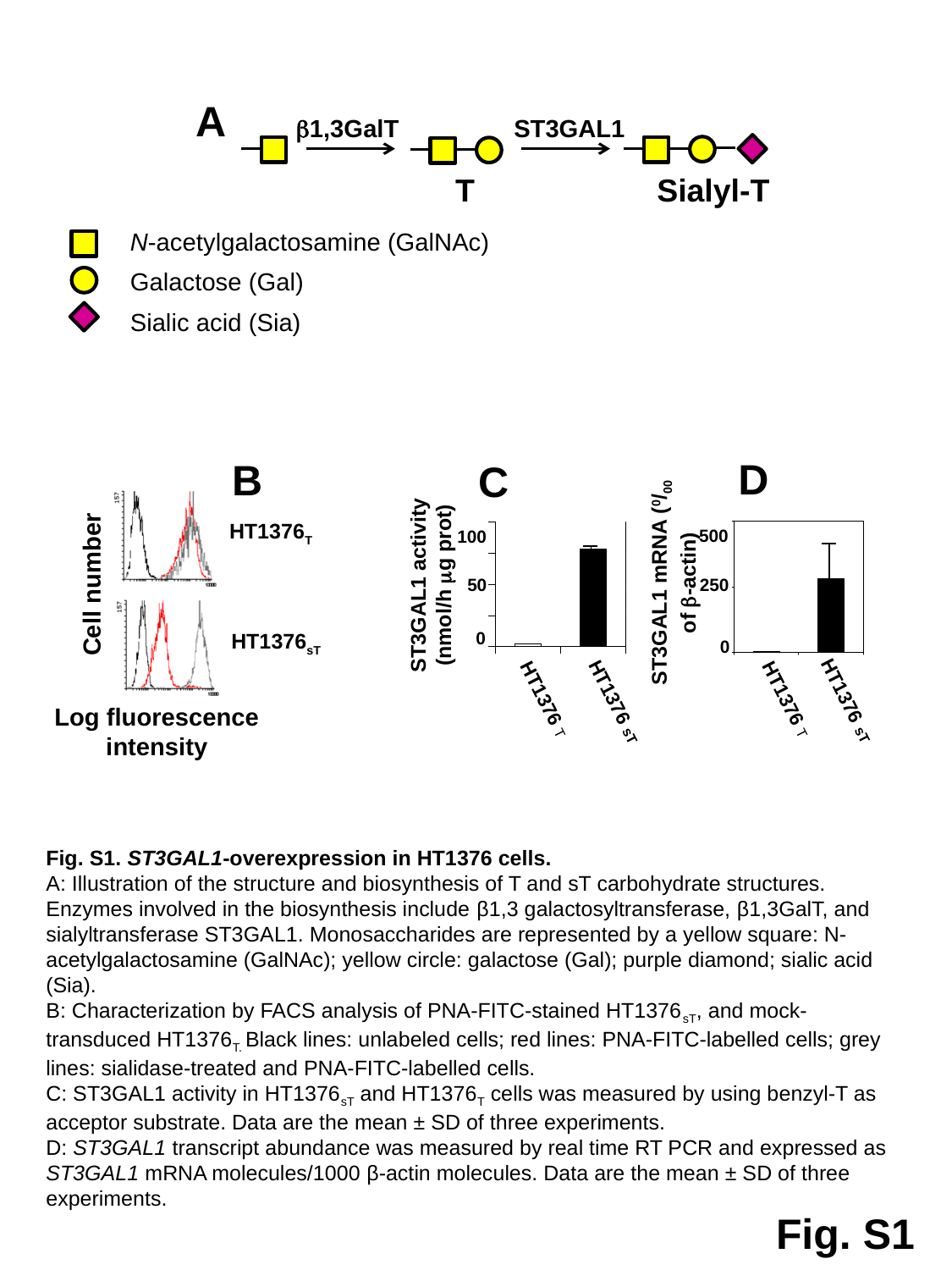
In chart C (ST3GAL1 activity), is the value for HT1376 T greater or less than 50? less In chart C (ST3GAL1 activity), is the value for HT1376 sT greater or less than 50? greater In chart D (ST3GAL1 mRNA), is the value for HT1376 T greater or less than 250? less In chart C (ST3GAL1 activity), which category has the highest value? HT1376 sT What is the highest y-axis tick value shown in chart D (ST3GAL1 mRNA)? 500 How many categories are plotted in chart C (ST3GAL1 activity)? 2 In chart C (ST3GAL1 activity), which category has the lowest value? HT1376 T In chart D (ST3GAL1 mRNA), which category has the highest value? HT1376 sT What kind of chart is chart C (ST3GAL1 activity)? bar chart In chart D (ST3GAL1 mRNA), which is larger, the value for HT1376 T or HT1376 sT? HT1376 sT What is the y-axis label of chart C? ST3GAL1 activity (nmol/h µg prot)